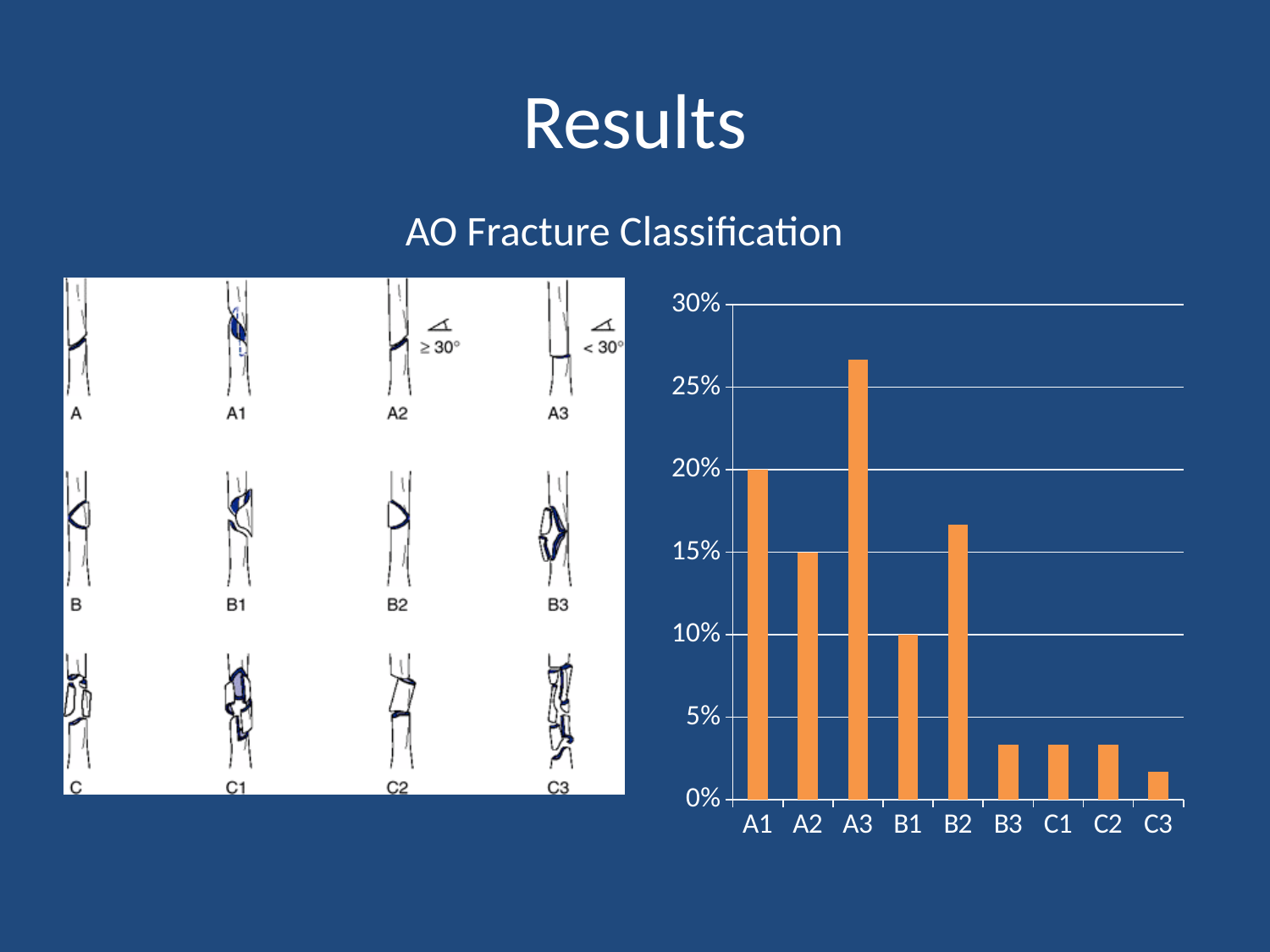
Which category has the highest value in the bar chart? A3 What kind of chart is shown on the slide? bar chart Is the value for B3 greater or less than 5%? less What is the value for A1 in the bar chart? 20% What is the value for A2 in the bar chart? 15% Is the value for B2 greater or less than 15%? greater How many categories are shown on the x axis of the bar chart? 9 Which is larger in the bar chart, the value for A1 or the value for B2? A1 Is the value for A3 greater or less than 25%? greater Which category has the lowest value in the bar chart? C3 What is the title shown above the chart and the fracture diagrams? AO Fracture Classification What is the value for B1 in the bar chart? 10%